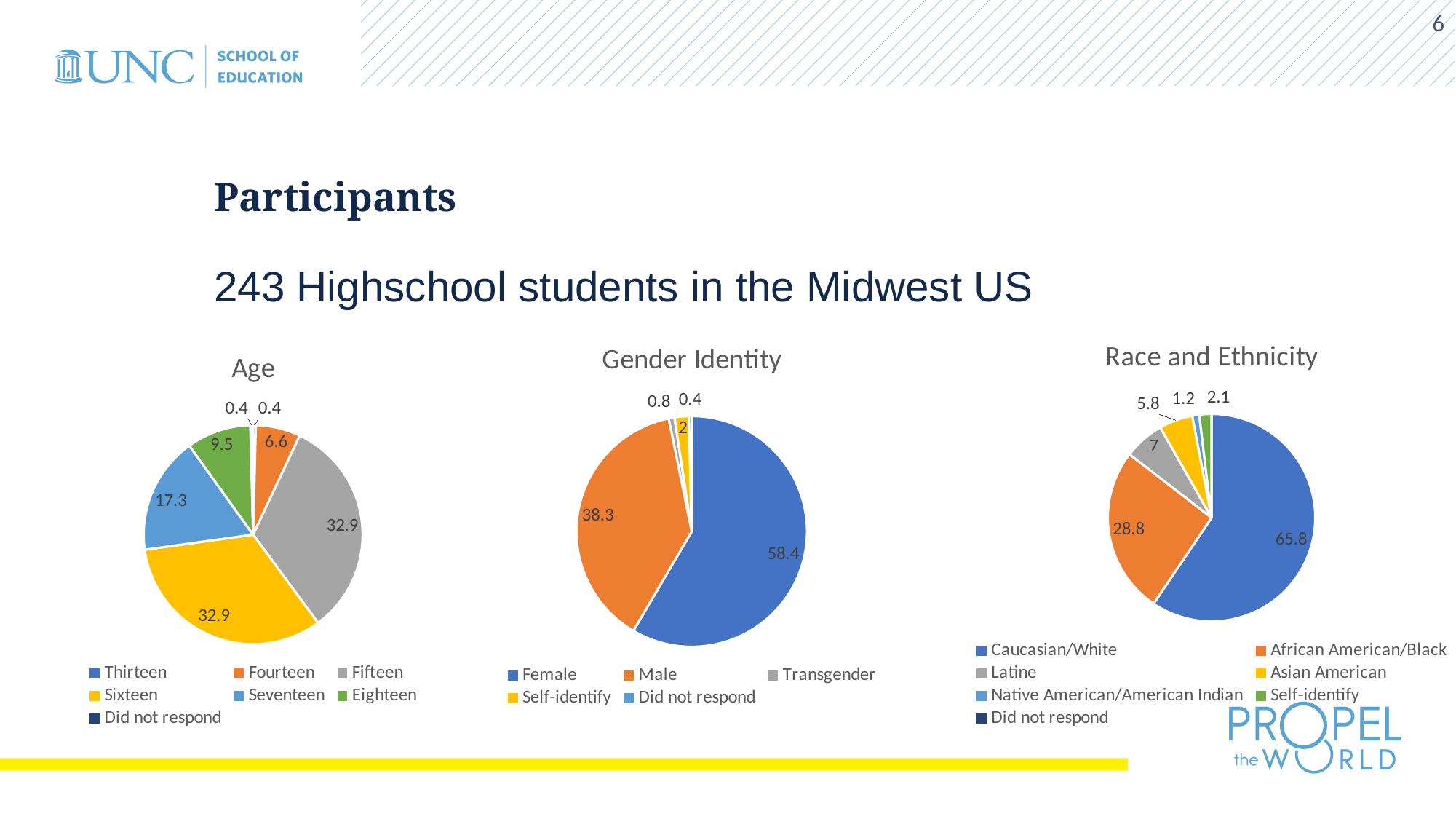
In the Gender Identity chart, what is the value for Male? 38.3 In the Gender Identity chart, what is the value for Female? 58.4 In the Age chart, what is the difference between the values for Seventeen and Eighteen? 7.8 In the Race and Ethnicity chart, what is the difference between the values for Caucasian/White and African American/Black? 37 In the Gender Identity chart, how many entries does the legend list? 5 In the Age chart, what is the value for Seventeen? 17.3 What type of chart is the Age chart? Pie chart In the Race and Ethnicity chart, which category has the largest slice? Caucasian/White In the Race and Ethnicity chart, what is the value for African American/Black? 28.8 In the Age chart, what percentage of participants are Fifteen? 32.9 In the Gender Identity chart, which category has the largest slice? Female In the Age chart, what is the value for Fourteen? 6.6